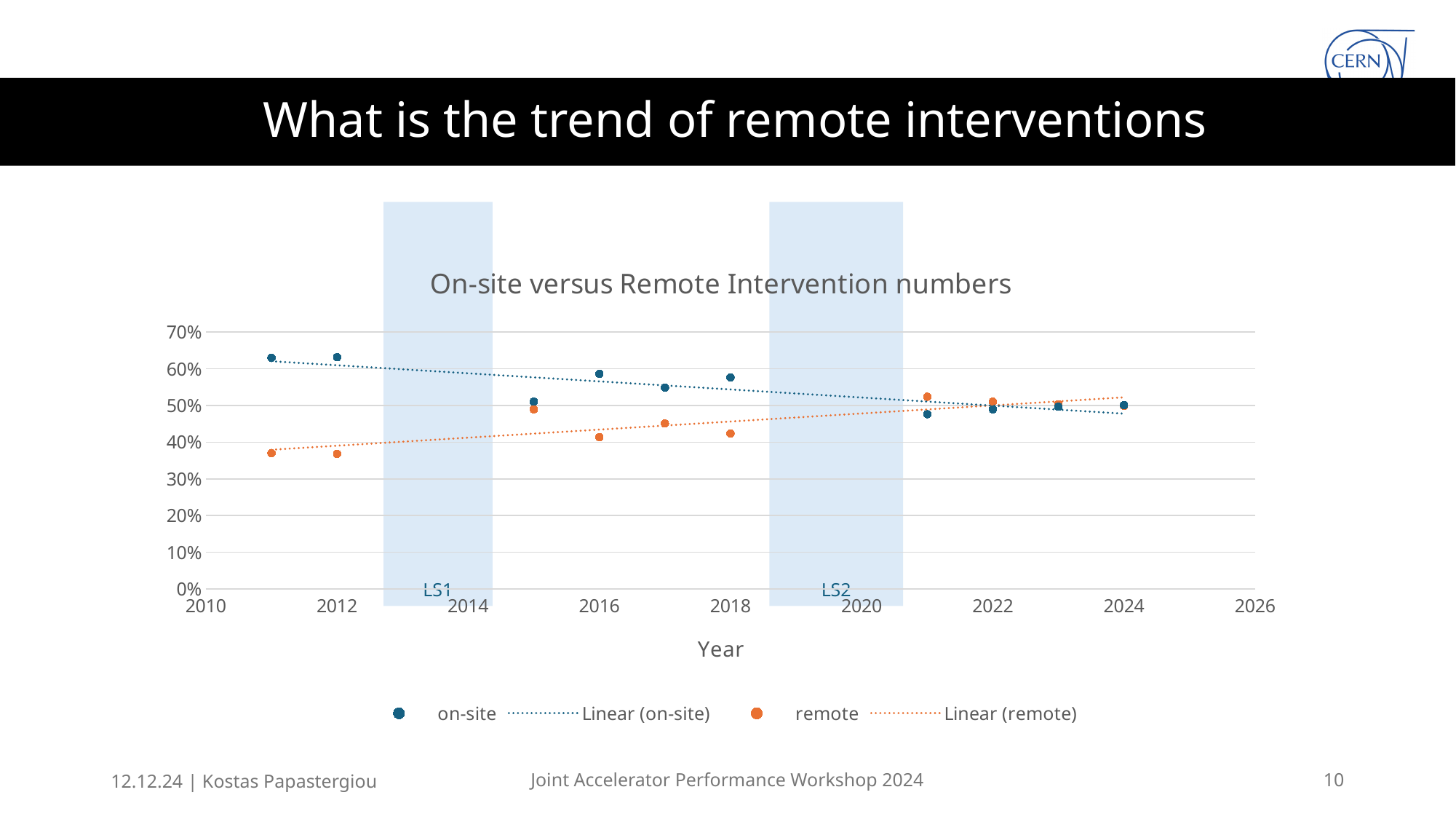
What kind of chart is shown on the slide? scatter chart Does the linear trendline for remote interventions rise or fall from 2011 to 2024? rise Is the on-site value for 2021 greater or less than 50%? less What is the title of the chart? On-site versus Remote Intervention numbers Does the linear trendline for on-site interventions rise or fall from 2011 to 2024? fall Is the remote value for 2011 greater or less than 40%? less How many entries does the chart legend list? 4 What are the labels of the two shaded regions on the chart? LS1 and LS2 Which is larger in 2011, the on-site value or the remote value? on-site Which is larger in 2021, the on-site value or the remote value? remote Is the on-site value for 2011 greater or less than 60%? greater How many years have data points plotted in the chart? 10